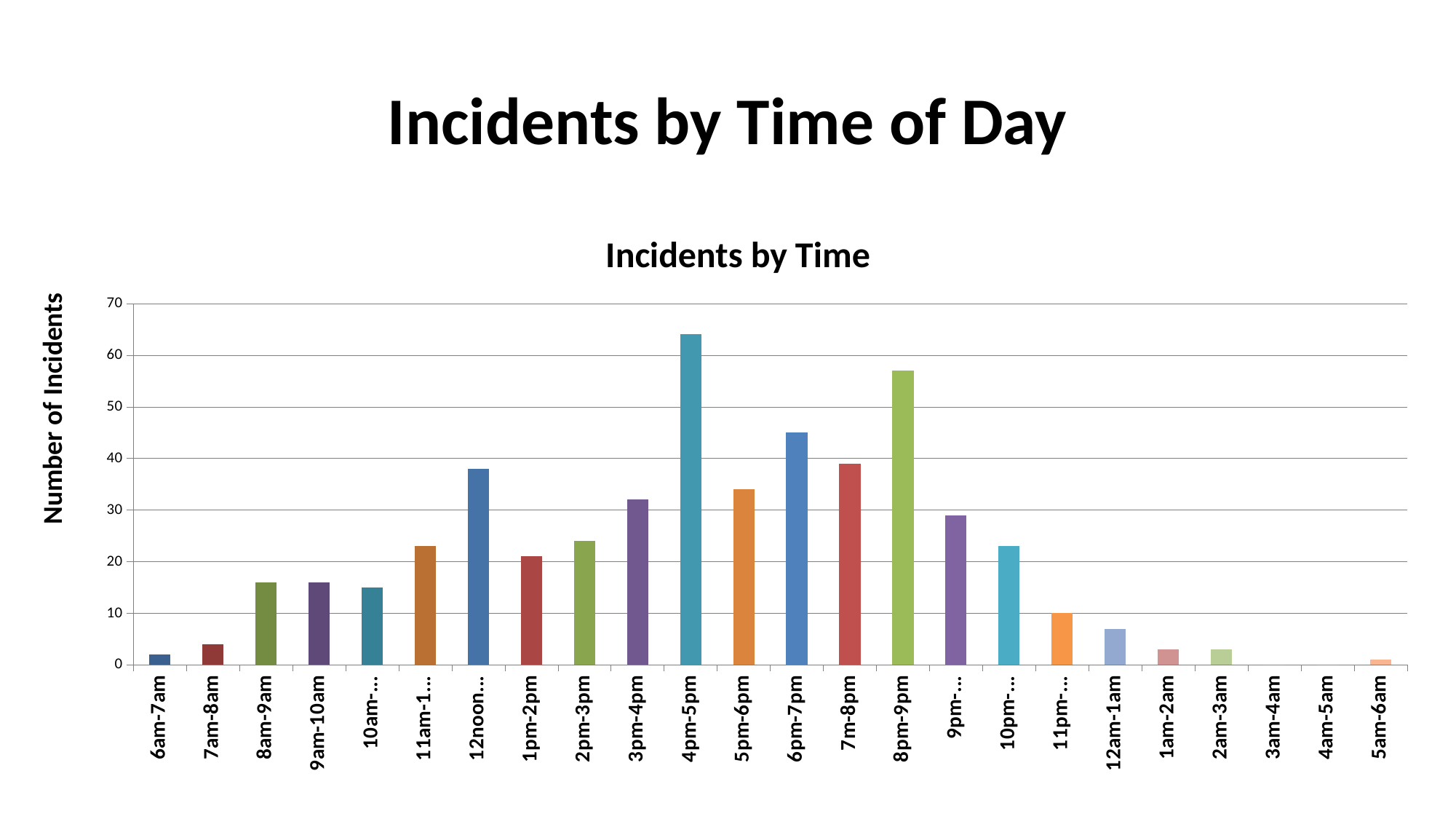
Which time slot has the highest number of incidents? 4pm-5pm Which has more incidents, 4pm-5pm or 8pm-9pm? 4pm-5pm Is the value for 5pm-6pm greater or less than 30? greater What is the label on the vertical axis? Number of Incidents Is the value for 8pm-9pm greater or less than 50? greater What is the title of the chart? Incidents by Time Is the value for 4pm-5pm greater or less than 60? greater What kind of chart is shown on the slide? bar chart Which has more incidents, 6pm-7pm or 7m-8pm? 6pm-7pm How many time-slot categories are shown on the x axis? 24